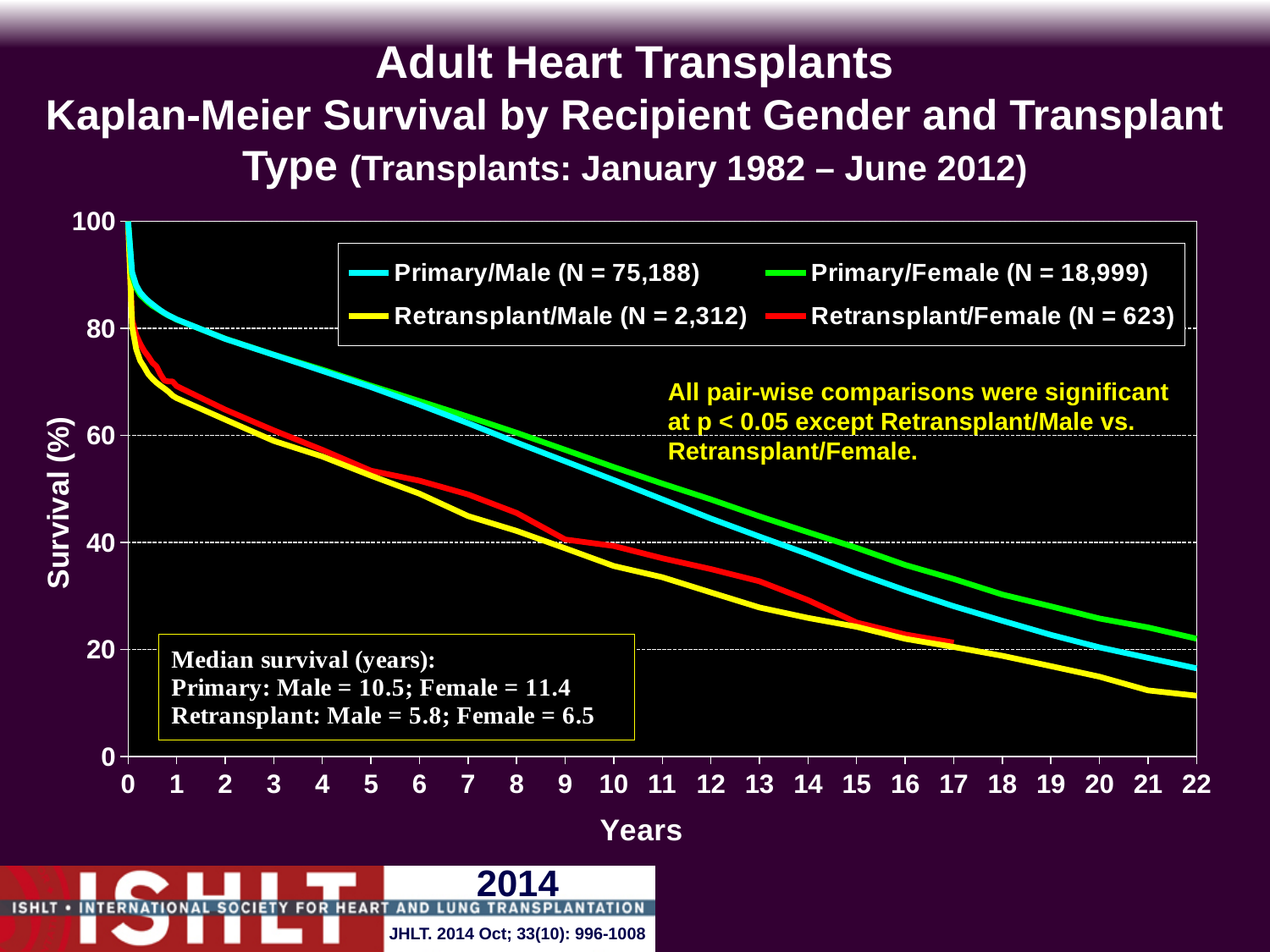
Which series has the highest survival at year 15? Primary/Female What is the N for the Primary/Male series in the legend? 75,188 How many series does the legend list? 4 What kind of chart is shown on the slide? line chart Is the survival value for Retransplant/Male at year 20 greater or less than 20? less Do the survival curves rise or fall as years increase? fall Is the survival value for Primary/Female at year 10 greater or less than 40? greater According to the text box, what is the median survival in years for Retransplant/Male recipients? 5.8 At year 5, which series has higher survival, Primary/Male or Retransplant/Male? Primary/Male According to the text box, what is the median survival in years for Primary/Female recipients? 11.4 What is the N for the Primary/Female series in the legend? 18,999 What is the N for the Retransplant/Female series in the legend? 623